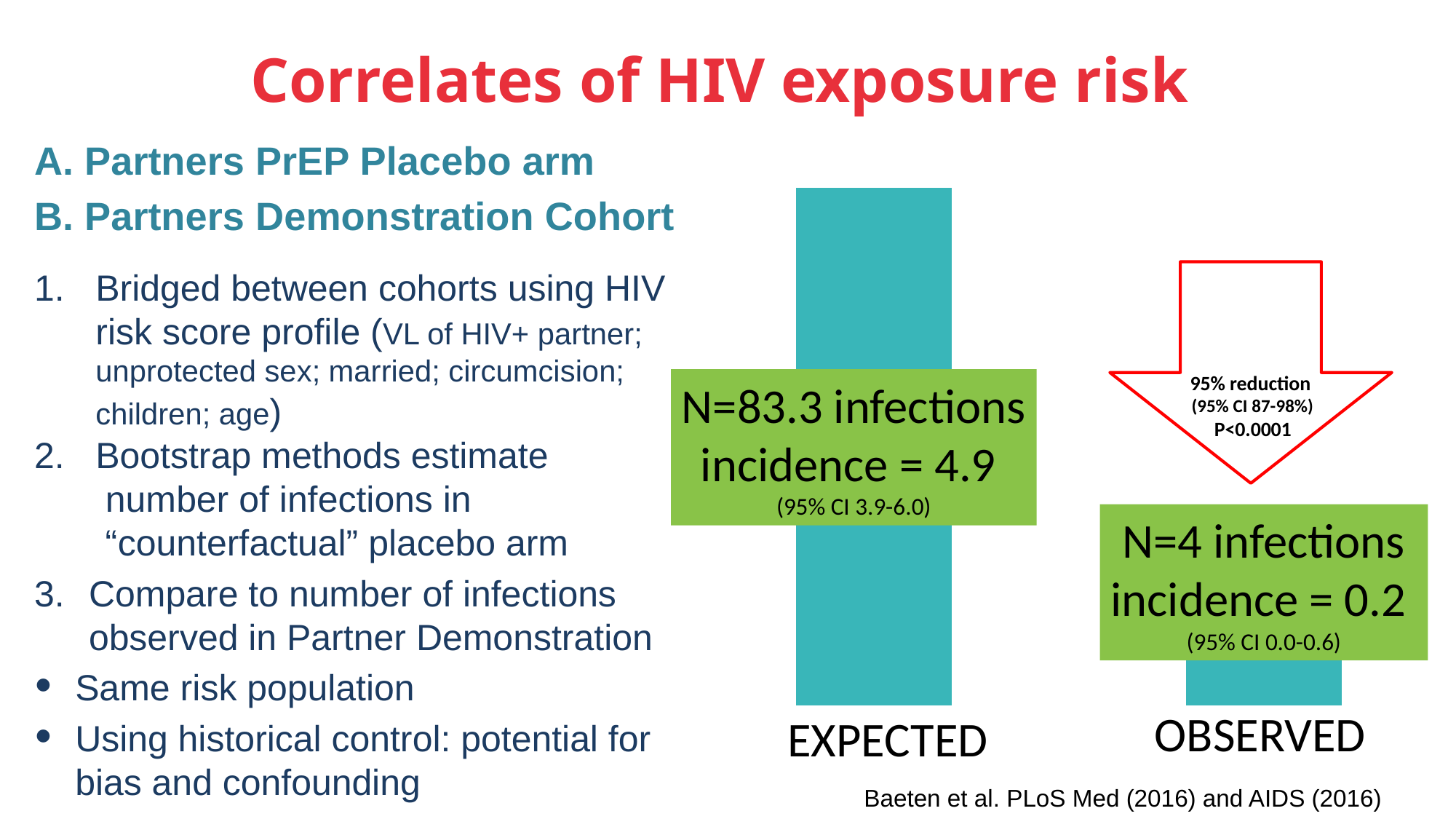
What percentage reduction is printed in the red arrow between the bars? 95% reduction What is the number of infections shown for the EXPECTED bar? N=83.3 infections What is the 95% confidence interval printed for the OBSERVED incidence? 95% CI 0.0-0.6 What incidence is shown for the EXPECTED bar? 4.9 What kind of chart compares EXPECTED and OBSERVED infections? Bar chart What is the 95% confidence interval printed for the EXPECTED incidence? 95% CI 3.9-6.0 Which bar shows the lowest number of infections? OBSERVED What incidence is shown for the OBSERVED bar? 0.2 How many bars are shown in the chart? 2 What is the number of infections shown for the OBSERVED bar? N=4 infections Which bar is taller, EXPECTED or OBSERVED? EXPECTED What is the difference in incidence between the EXPECTED and OBSERVED bars? 4.7